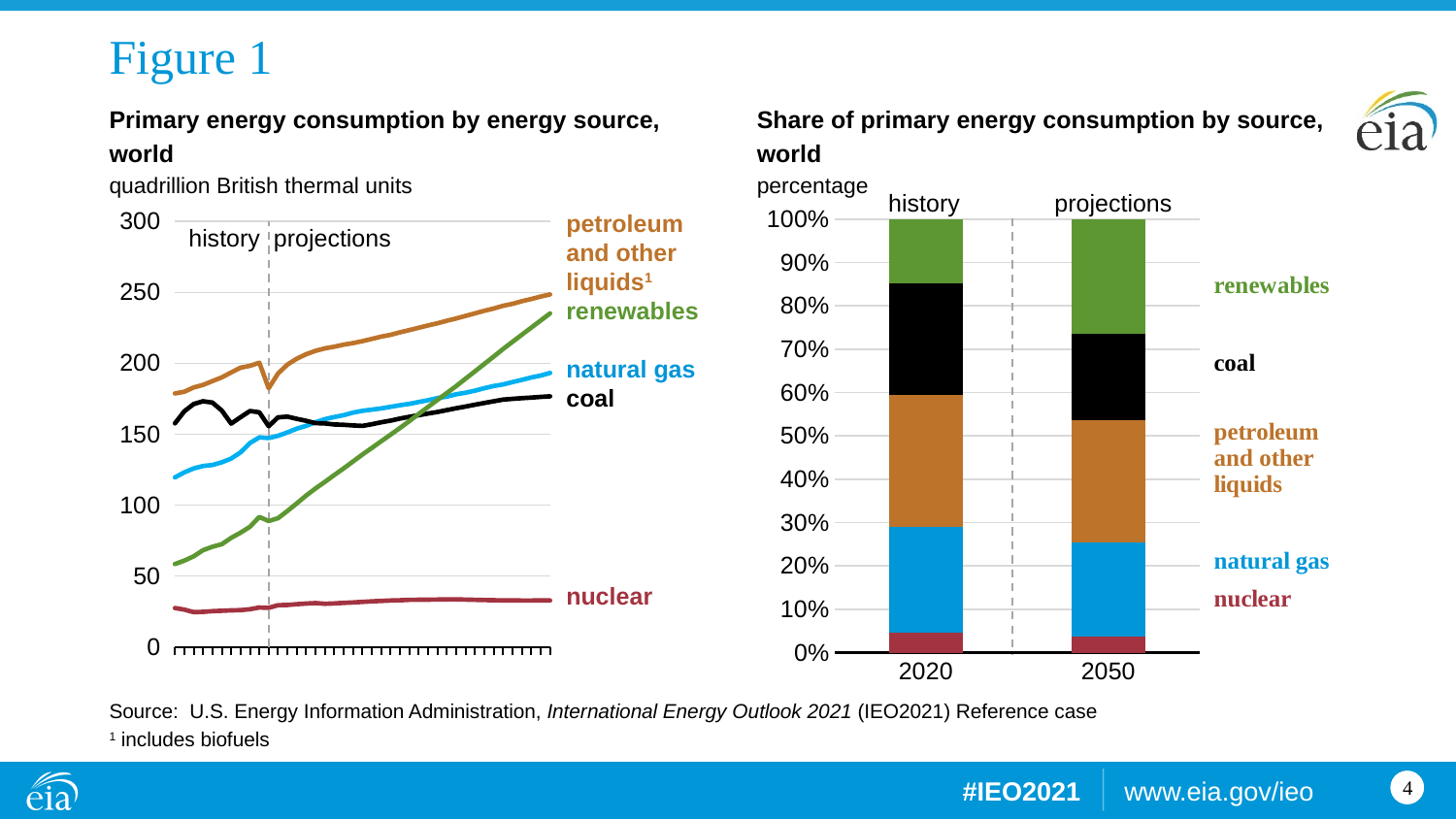
In the right chart, 'Share of primary energy consumption by source, world', how many years are shown on the x axis? 2 In the left chart, 'Primary energy consumption by energy source, world', which energy source has the lowest consumption at the end of the projection period? nuclear What kind of chart is the right chart, 'Share of primary energy consumption by source, world'? bar chart In the left chart, 'Primary energy consumption by energy source, world', which energy source has the highest consumption at the end of the projection period? petroleum and other liquids In the left chart, 'Primary energy consumption by energy source, world', is the value for nuclear at the end of the projection period greater or less than 50? less In the left chart, 'Primary energy consumption by energy source, world', how many energy source series are plotted? 5 What unit is used on the y axis of the left chart, 'Primary energy consumption by energy source, world'? quadrillion British thermal units In the left chart, 'Primary energy consumption by energy source, world', is the value for renewables at the end of the projection period greater or less than 200? greater In the left chart, 'Primary energy consumption by energy source, world', does renewables consumption rise or fall over the projection period? rise What kind of chart is the left chart, 'Primary energy consumption by energy source, world'? line chart In the right chart, 'Share of primary energy consumption by source, world', is the share of renewables in 2050 greater or less than 20%? greater In the right chart, 'Share of primary energy consumption by source, world', is the share of coal larger in 2020 or in 2050? 2020